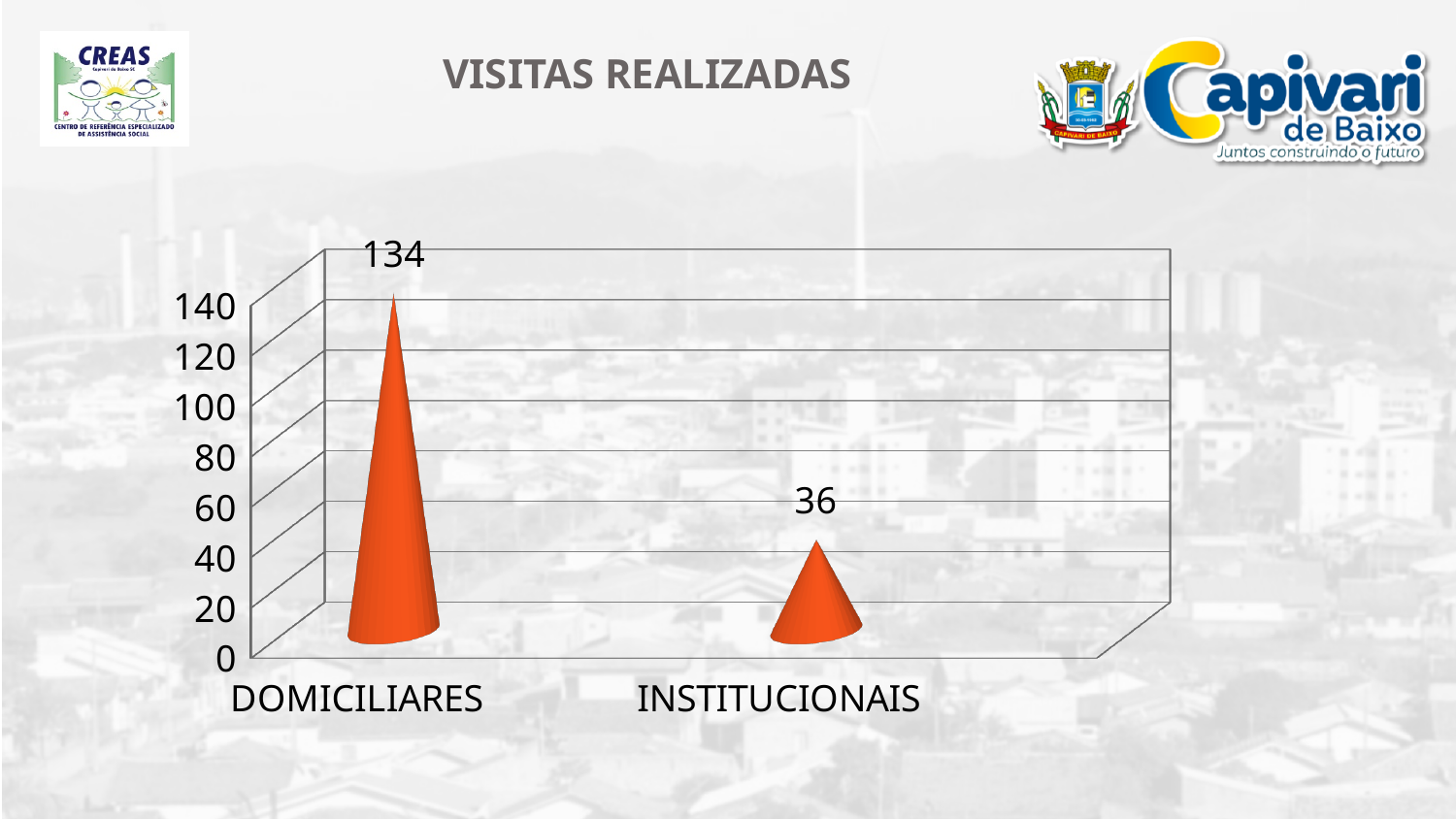
What is the highest value shown on the vertical axis? 140 What is the difference between the values for DOMICILIARES and INSTITUCIONAIS? 98 Which category has the lowest value? INSTITUCIONAIS Is the value for DOMICILIARES greater or less than 120? greater What is the value for INSTITUCIONAIS? 36 Which category has the highest value? DOMICILIARES What is the title of the slide? VISITAS REALIZADAS What is the value for DOMICILIARES? 134 What kind of chart is shown on the slide? bar chart Which is larger, the value for DOMICILIARES or the value for INSTITUCIONAIS? DOMICILIARES Is the value for INSTITUCIONAIS greater or less than 40? less How many categories are shown on the chart? 2